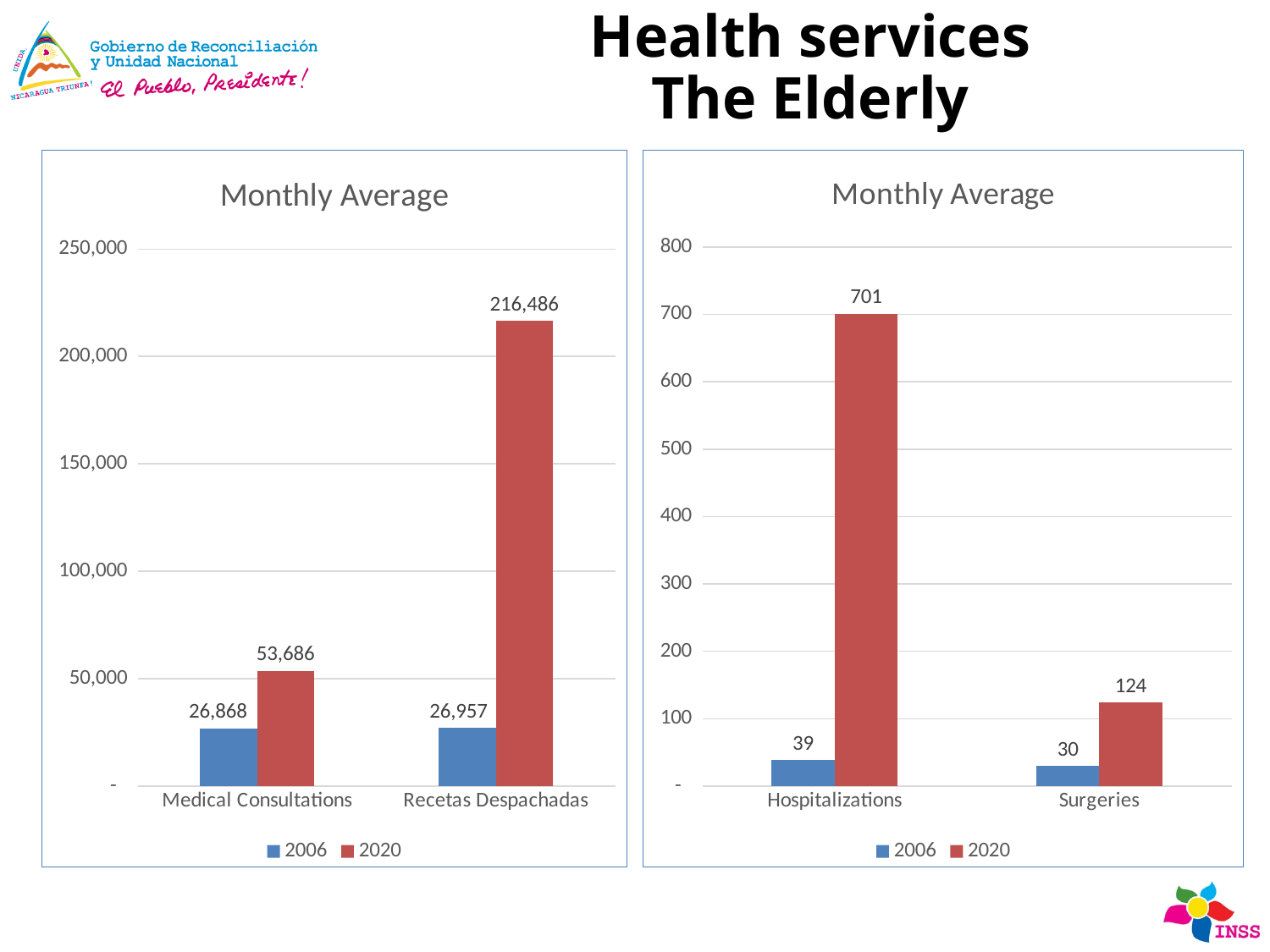
In the right chart, what is the 2006 value for Surgeries? 30 In the left chart, what is the 2020 value for Recetas Despachadas? 216,486 In the right chart, which is larger: the 2020 value for Surgeries or the 2006 value for Hospitalizations? 2020 value for Surgeries What type of chart is the right chart? Bar chart What is the title of the left chart? Monthly Average In the right chart, what is the difference between the 2020 and 2006 values for Hospitalizations? 662 How many series does the legend of the left chart list? 2 In the left chart, what is the 2006 value for Medical Consultations? 26,868 In the right chart, which category has the lowest 2006 value? Surgeries In the left chart, what is the difference between the 2020 and 2006 values for Medical Consultations? 26,818 In the right chart, what is the 2020 value for Hospitalizations? 701 In the left chart, which category has the highest 2020 value? Recetas Despachadas